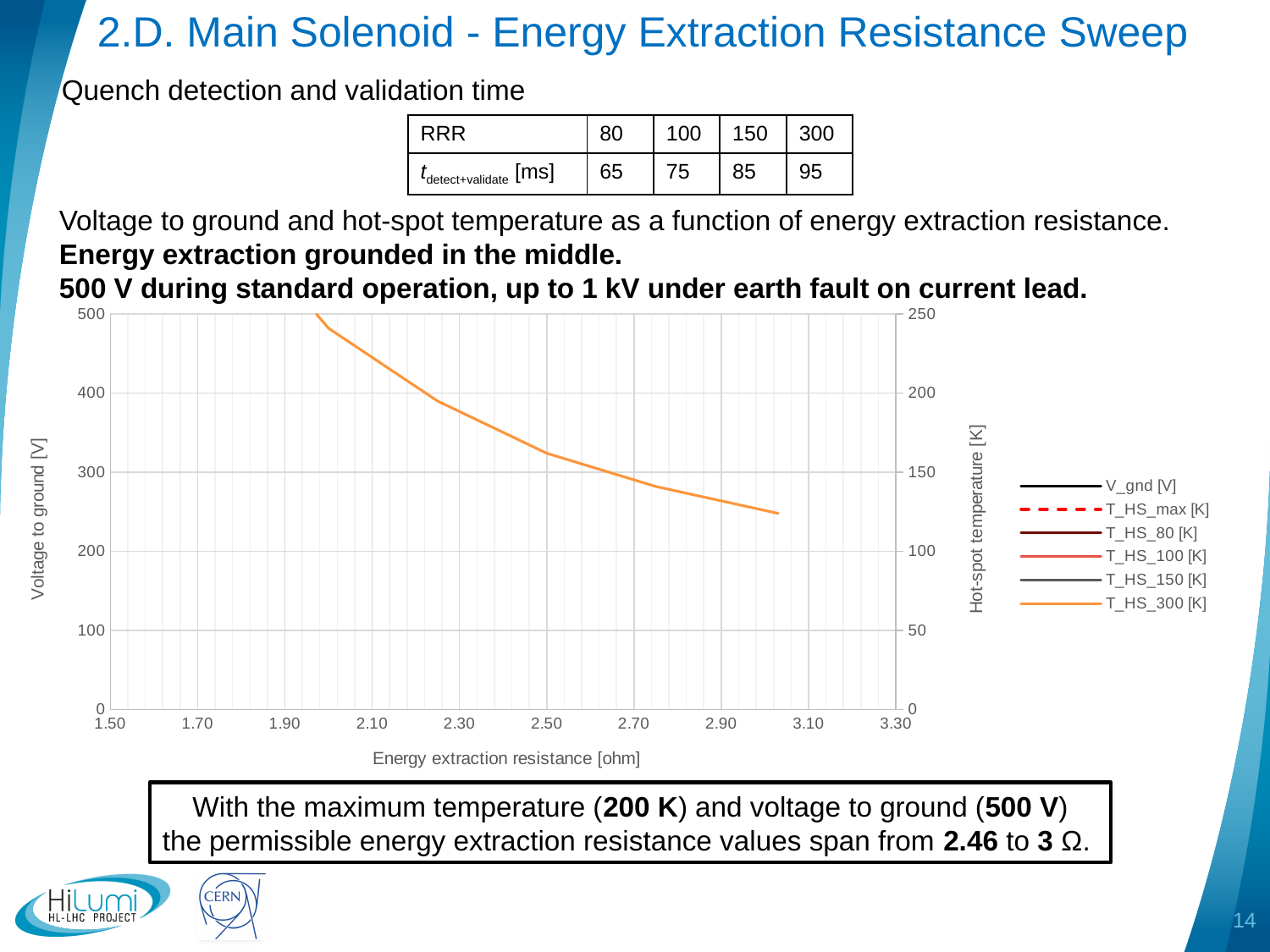
Which legend entry is drawn with a dashed line? T_HS_max [K] Is the hot-spot temperature of the plotted T_HS_300 [K] line at 2.10 ohm greater or less than 200 K? greater What kind of chart is shown on the slide? line chart How many series does the chart legend list? 6 Is the hot-spot temperature of the plotted T_HS_300 [K] line at 2.50 ohm greater or less than 150 K? greater What is the title of the chart's x axis? Energy extraction resistance [ohm] Is the hot-spot temperature of the plotted T_HS_300 [K] line at 3.00 ohm greater or less than 150 K? less Does the plotted orange line rise or fall as energy extraction resistance increases? fall